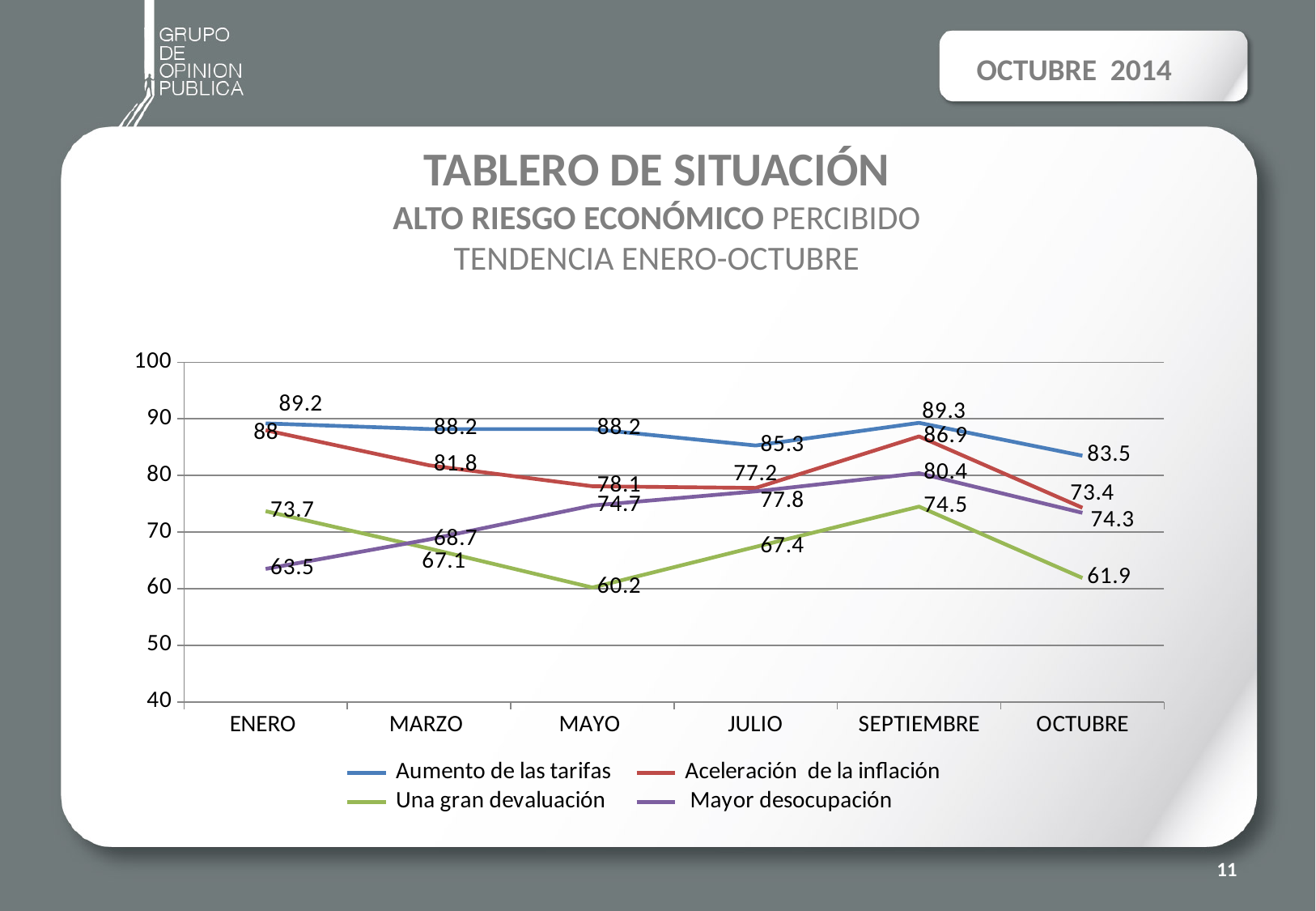
What is the value for Aceleración de la inflación in OCTUBRE? 74.3 What is the value for Mayor desocupación in SEPTIEMBRE? 80.4 How many months are shown on the x axis? 6 What kind of chart is shown on the slide? line chart In which month is Aumento de las tarifas highest? SEPTIEMBRE In which month is Una gran devaluación lowest? MAYO What is the value for Aumento de las tarifas in ENERO? 89.2 What is the value for Una gran devaluación in MAYO? 60.2 Which is larger in ENERO: Una gran devaluación or Mayor desocupación? Una gran devaluación How many series does the legend list? 4 What is the difference between Aumento de las tarifas and Aceleración de la inflación in OCTUBRE? 9.2 Does Mayor desocupación rise or fall from ENERO to SEPTIEMBRE? rise